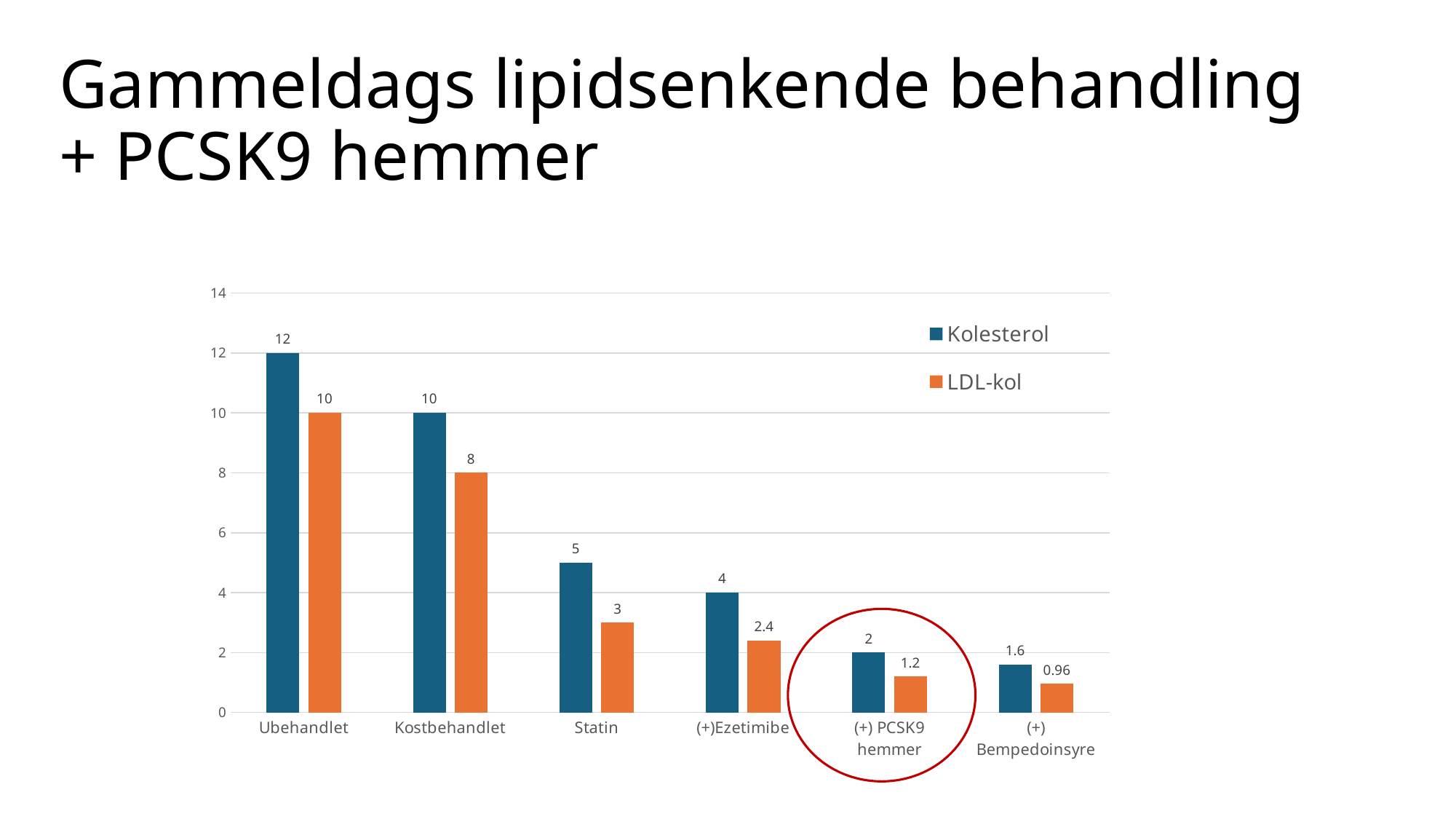
Which is larger, the Kolesterol value for (+)Ezetimibe or the LDL-kol value for Kostbehandlet? LDL-kol for Kostbehandlet Which category has the lowest LDL-kol value? (+) Bempedoinsyre What is the difference between the Kolesterol and LDL-kol values for Statin? 2 What is the LDL-kol value for (+) PCSK9 hemmer? 1.2 What is the LDL-kol value for (+) Bempedoinsyre? 0.96 How many series does the legend list? 2 What is the difference between the LDL-kol values for Kostbehandlet and (+)Ezetimibe? 5.6 Do the Kolesterol values rise or fall from left to right along the x axis? Fall What kind of chart is shown on the slide? Bar chart How many categories are shown on the x axis? 6 What is the Kolesterol value for Ubehandlet? 12 Which category has the highest Kolesterol value? Ubehandlet